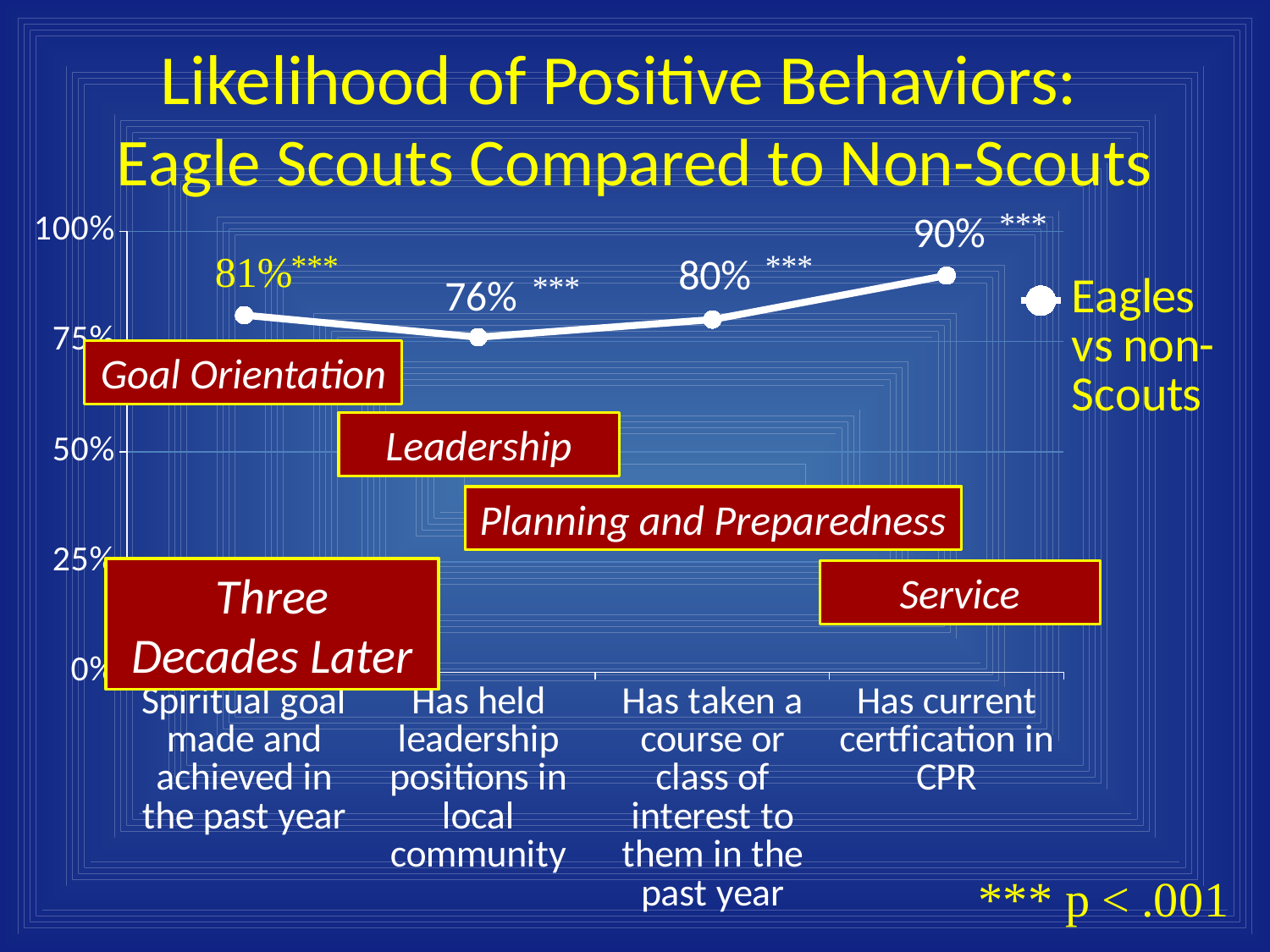
Which is larger: the value for "Spiritual goal made and achieved in the past year" or the value for "Has taken a course or class of interest to them in the past year"? Spiritual goal made and achieved in the past year Is the value for "Has held leadership positions in local community" greater or less than 75%? greater Which category has the highest value? Has current certfication in CPR What kind of chart is shown on the slide? line chart How many categories are plotted on the x axis? 4 What is the value for "Has taken a course or class of interest to them in the past year"? 80% What is the difference between the value for "Has current certfication in CPR" and the value for "Has held leadership positions in local community"? 14% What is the value for "Has current certfication in CPR"? 90% What series name does the legend list? Eagles vs non-Scouts What is the value for "Spiritual goal made and achieved in the past year"? 81% Which category has the lowest value? Has held leadership positions in local community What is the value for "Has held leadership positions in local community"? 76%